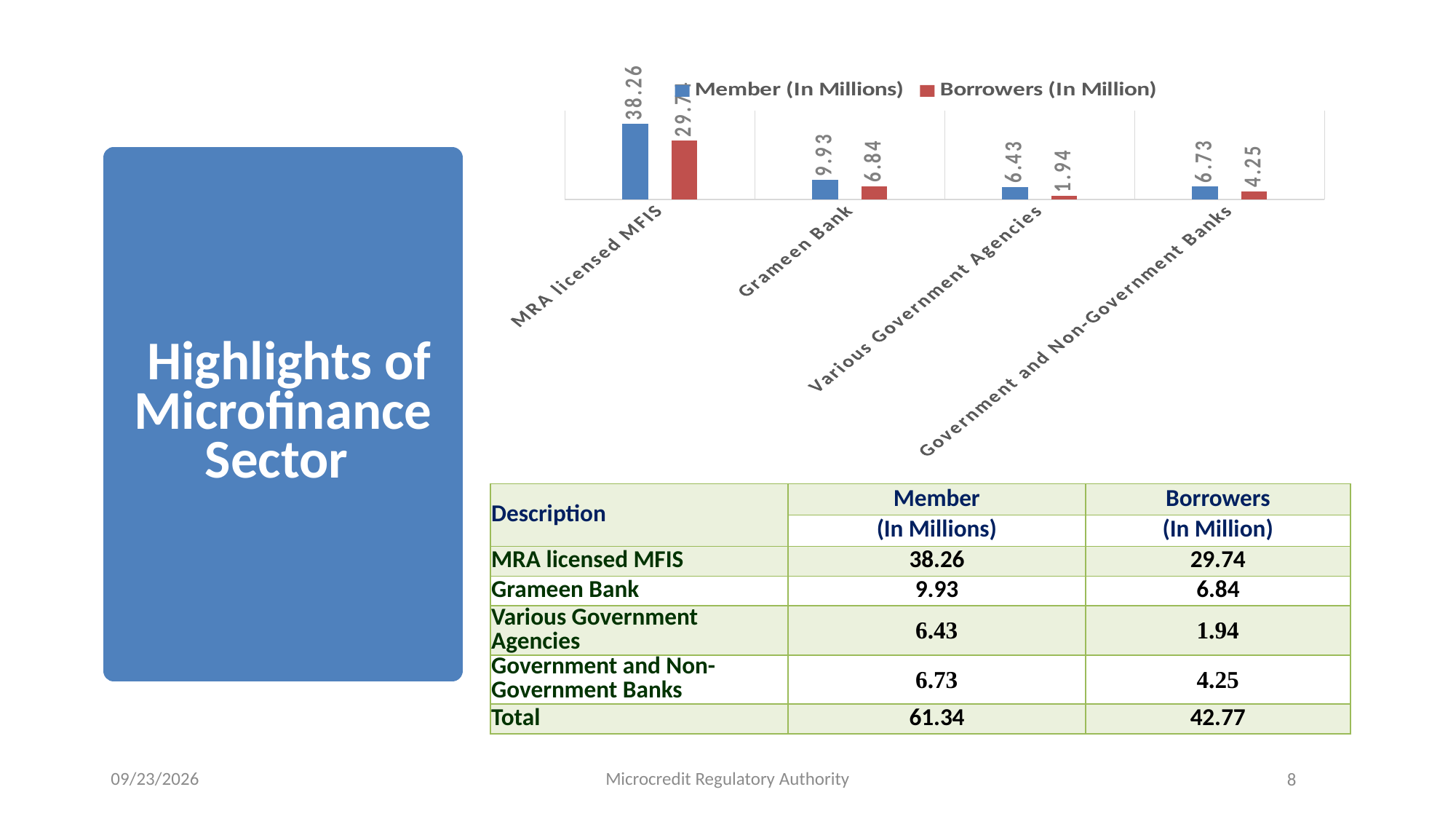
Which is larger, the Member value for Various Government Agencies or the Member value for Government and Non-Government Banks? Government and Non-Government Banks What is the Borrowers (In Million) value for Various Government Agencies? 1.94 What is the Member (In Millions) value for Government and Non-Government Banks? 6.73 Which category has the lowest Borrowers (In Million) value? Various Government Agencies Which category has the highest Member (In Millions) value? MRA licensed MFIS What is the difference between the Borrowers values for Government and Non-Government Banks and Various Government Agencies? 2.31 What is the Member (In Millions) value for Grameen Bank? 9.93 What type of chart is shown on the slide? bar chart How many categories are shown on the chart's x axis? 4 What is the difference between the Member and Borrowers values for Grameen Bank? 3.09 How many series does the chart legend list? 2 Which colour represents the Borrowers (In Million) series in the chart? red